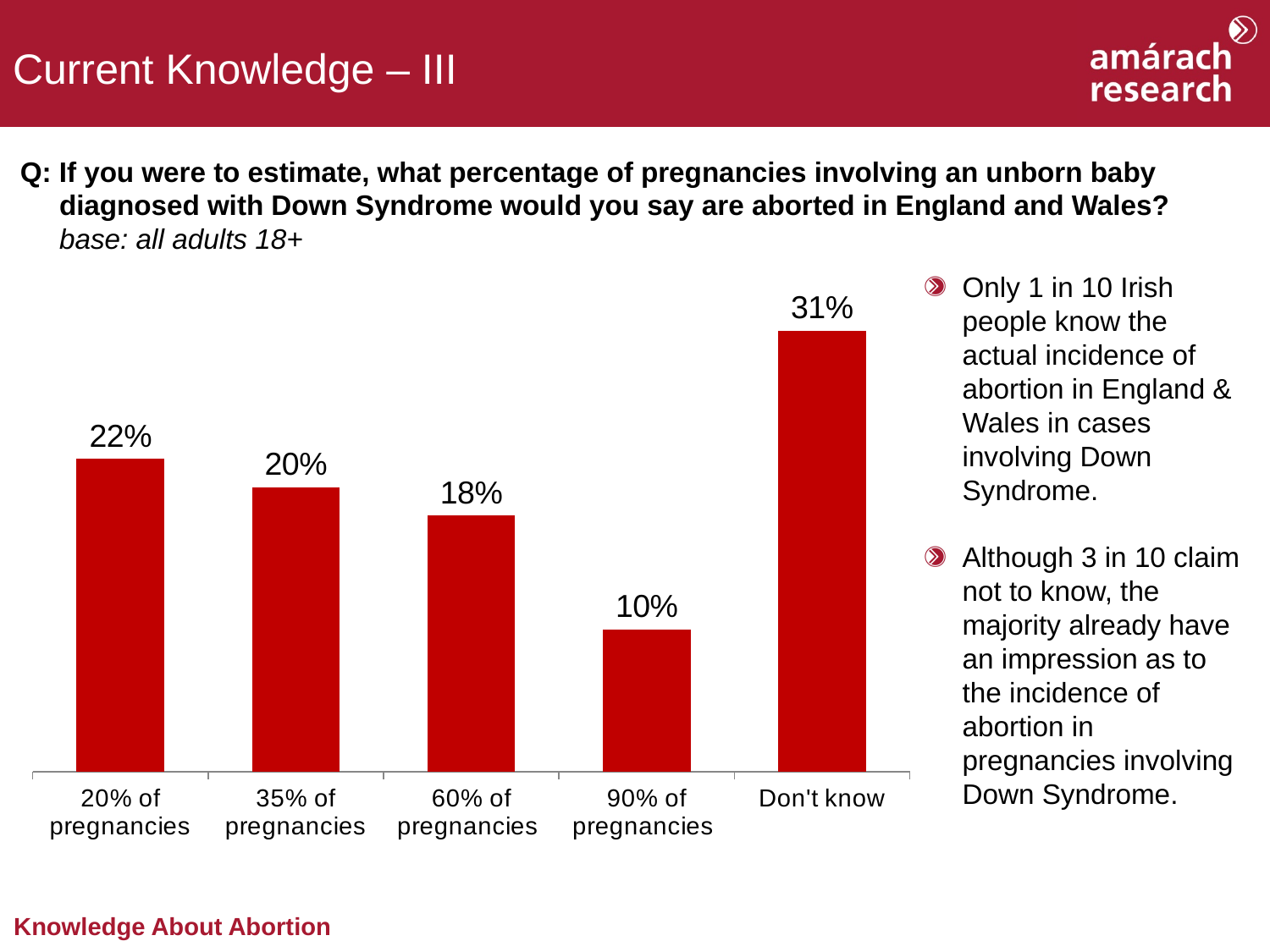
Do the values rise or fall across the first four categories from '20% of pregnancies' to '90% of pregnancies'? Fall What is the value for the '60% of pregnancies' category? 18% What kind of chart is shown on the slide? Bar chart What percentage of respondents estimated that 20% of pregnancies are aborted? 22% Which is larger, the value for '20% of pregnancies' or the value for '60% of pregnancies'? 20% of pregnancies What is the difference between the 'Don't know' value and the '20% of pregnancies' value? 9% What is the difference between the values for '35% of pregnancies' and '90% of pregnancies'? 10% Which category has the highest value in the chart? Don't know How many categories are shown on the x axis of the chart? 5 What percentage of respondents estimated that 90% of pregnancies are aborted? 10% What is the value shown for the 'Don't know' category? 31% Which category has the lowest value in the chart? 90% of pregnancies